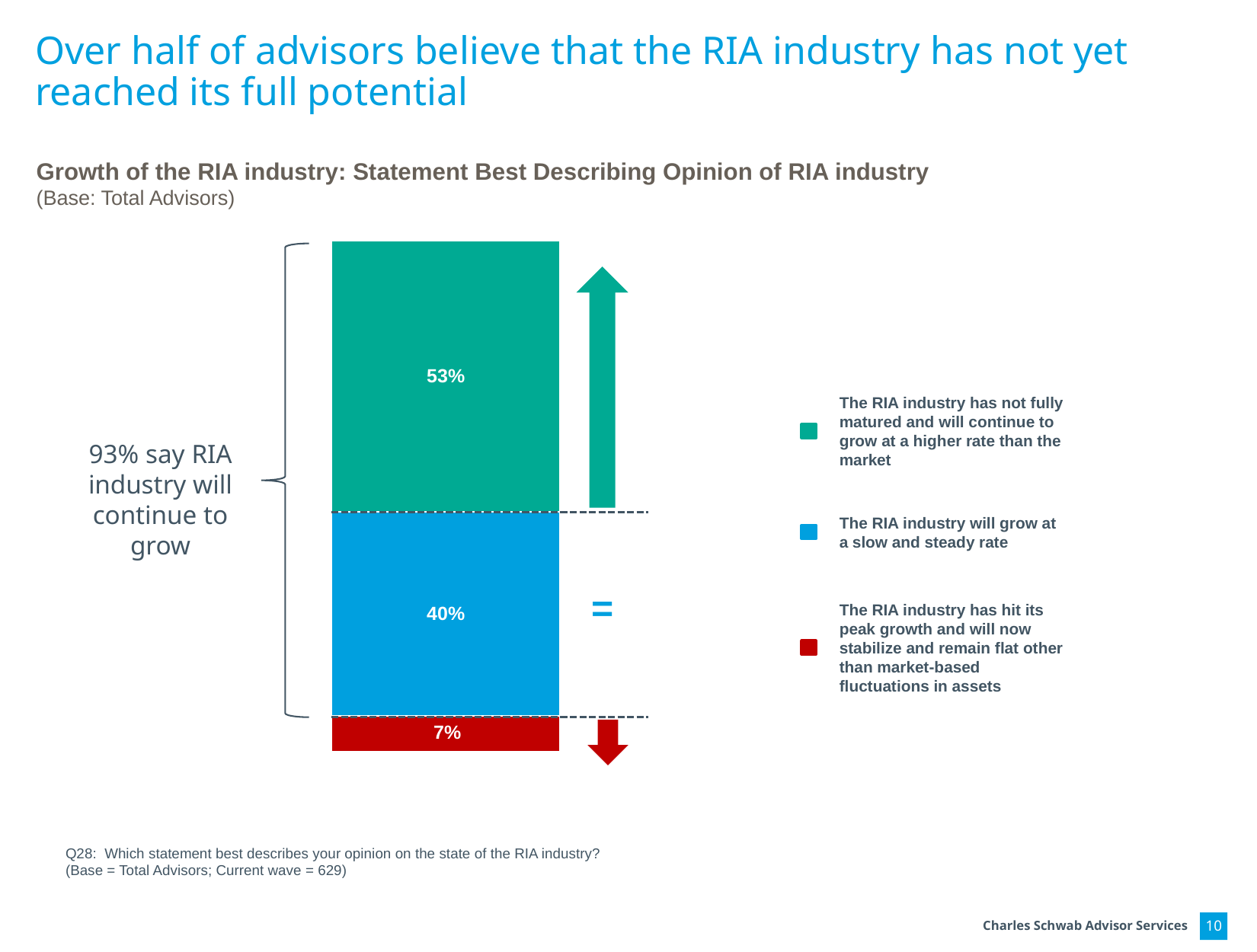
What colour is the segment representing advisors who say the RIA industry has hit its peak growth? Red Which is larger: the share saying the industry will grow at a slow and steady rate or the share saying it has hit its peak growth? The share saying it will grow at a slow and steady rate What percentage of advisors say the RIA industry has hit its peak growth and will now stabilize and remain flat? 7% Which statement received the largest share of advisors? The RIA industry has not fully matured and will continue to grow at a higher rate than the market What percentage of advisors say the RIA industry will grow at a slow and steady rate? 40% What is the difference in percentage points between the share saying the industry will grow at a higher rate than the market and the share saying it will grow at a slow and steady rate? 13 percentage points Which statement received the smallest share of advisors? The RIA industry has hit its peak growth and will now stabilize and remain flat other than market-based fluctuations in assets What is the combined percentage of advisors who say the RIA industry will continue to grow? 93% What percentage of advisors say the RIA industry has not fully matured and will continue to grow at a higher rate than the market? 53% How many entries does the legend list? 3 How many statements (segments) are shown in the stacked bar? 3 What type of chart is shown on the slide? Stacked bar chart